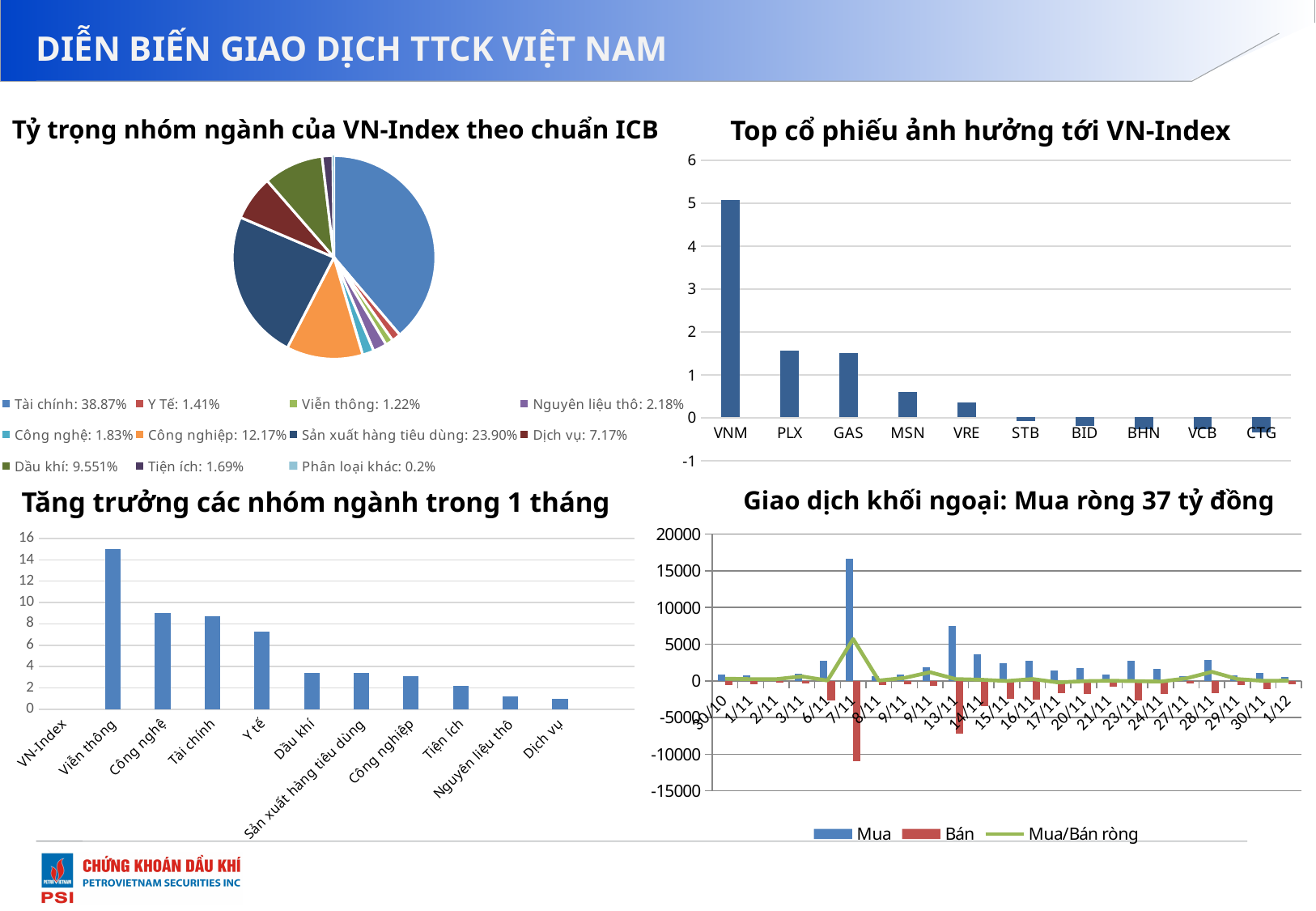
In the chart 'Top cổ phiếu ảnh hưởng tới VN-Index', which stock has the highest value? VNM In the pie chart 'Tỷ trọng nhóm ngành của VN-Index theo chuẩn ICB', how many categories are listed in the legend? 11 In the pie chart 'Tỷ trọng nhóm ngành của VN-Index theo chuẩn ICB', what is the share of Tài chính? 38.87% In the chart 'Top cổ phiếu ảnh hưởng tới VN-Index', how many stocks are shown on the x axis? 10 In the pie chart 'Tỷ trọng nhóm ngành của VN-Index theo chuẩn ICB', what is the share of Sản xuất hàng tiêu dùng? 23.90% In the pie chart 'Tỷ trọng nhóm ngành của VN-Index theo chuẩn ICB', which is larger: Công nghiệp or Dầu khí? Công nghiệp In the chart 'Giao dịch khối ngoại: Mua ròng 37 tỷ đồng', is the Mua value on 7/11 greater or less than 15000? greater In the chart 'Giao dịch khối ngoại: Mua ròng 37 tỷ đồng', how many series does the legend list? 3 In the pie chart 'Tỷ trọng nhóm ngành của VN-Index theo chuẩn ICB', which sector has the largest share? Tài chính In the chart 'Top cổ phiếu ảnh hưởng tới VN-Index', is the value for VNM greater or less than 4? greater In the pie chart 'Tỷ trọng nhóm ngành của VN-Index theo chuẩn ICB', which category has the smallest share? Phân loại khác What kind of chart is 'Tăng trưởng các nhóm ngành trong 1 tháng'? bar chart